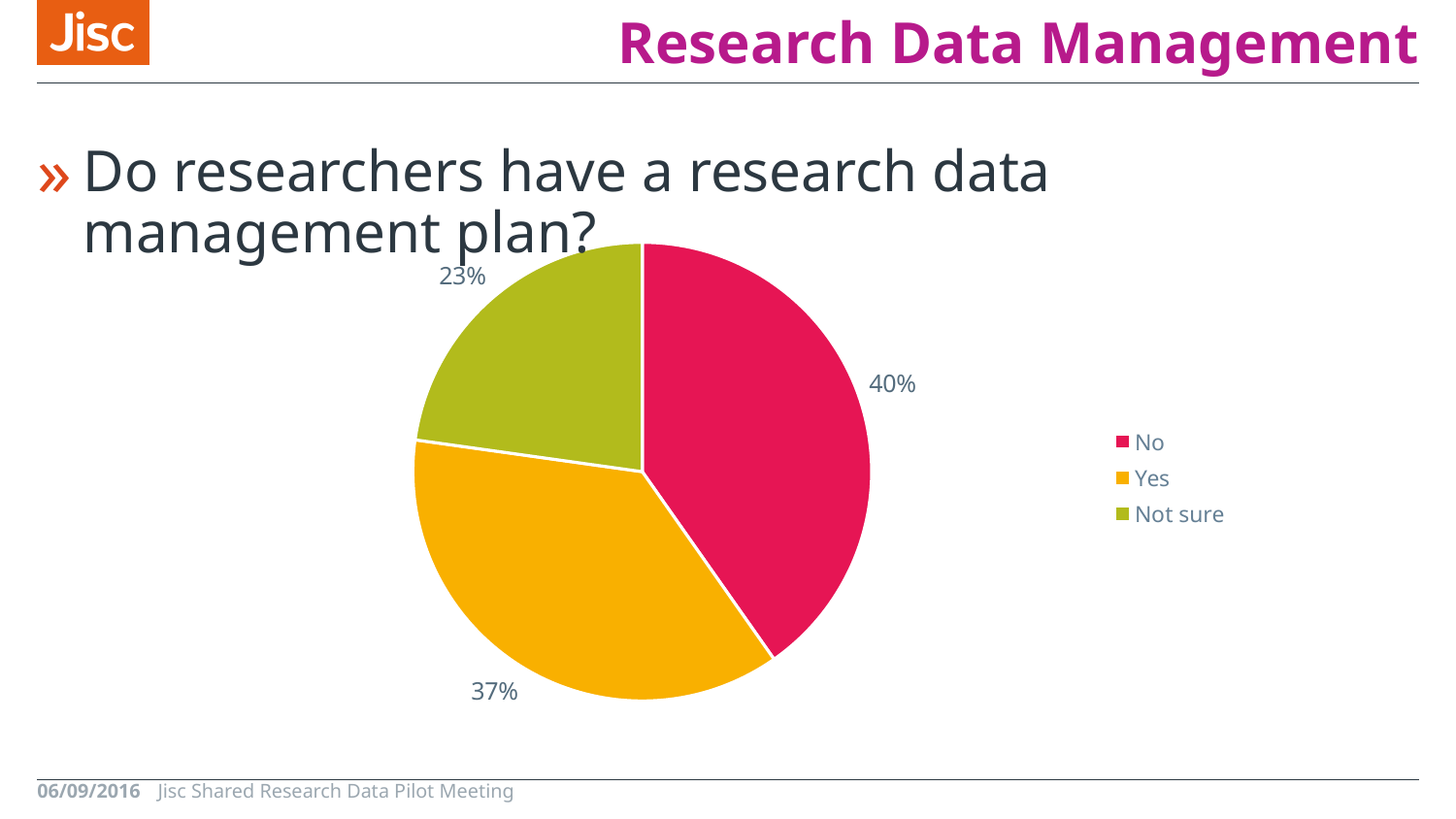
What percentage of researchers answered "No" to having a research data management plan? 40% What is the difference in percentage points between the "Yes" and "Not sure" shares? 14 How many categories does the pie chart have? 3 What is the combined share of "No" and "Yes" responses? 77% How many percentage points larger is the "No" share than the "Yes" share? 3 What percentage of researchers answered "Yes"? 37% What kind of chart is shown on the slide? pie chart What percentage of researchers answered "Not sure"? 23% Which response has the largest share of the pie? No Which is larger, the "Yes" share or the "Not sure" share? Yes Which colour represents "Not sure" in the pie chart? green Which response has the smallest share of the pie? Not sure